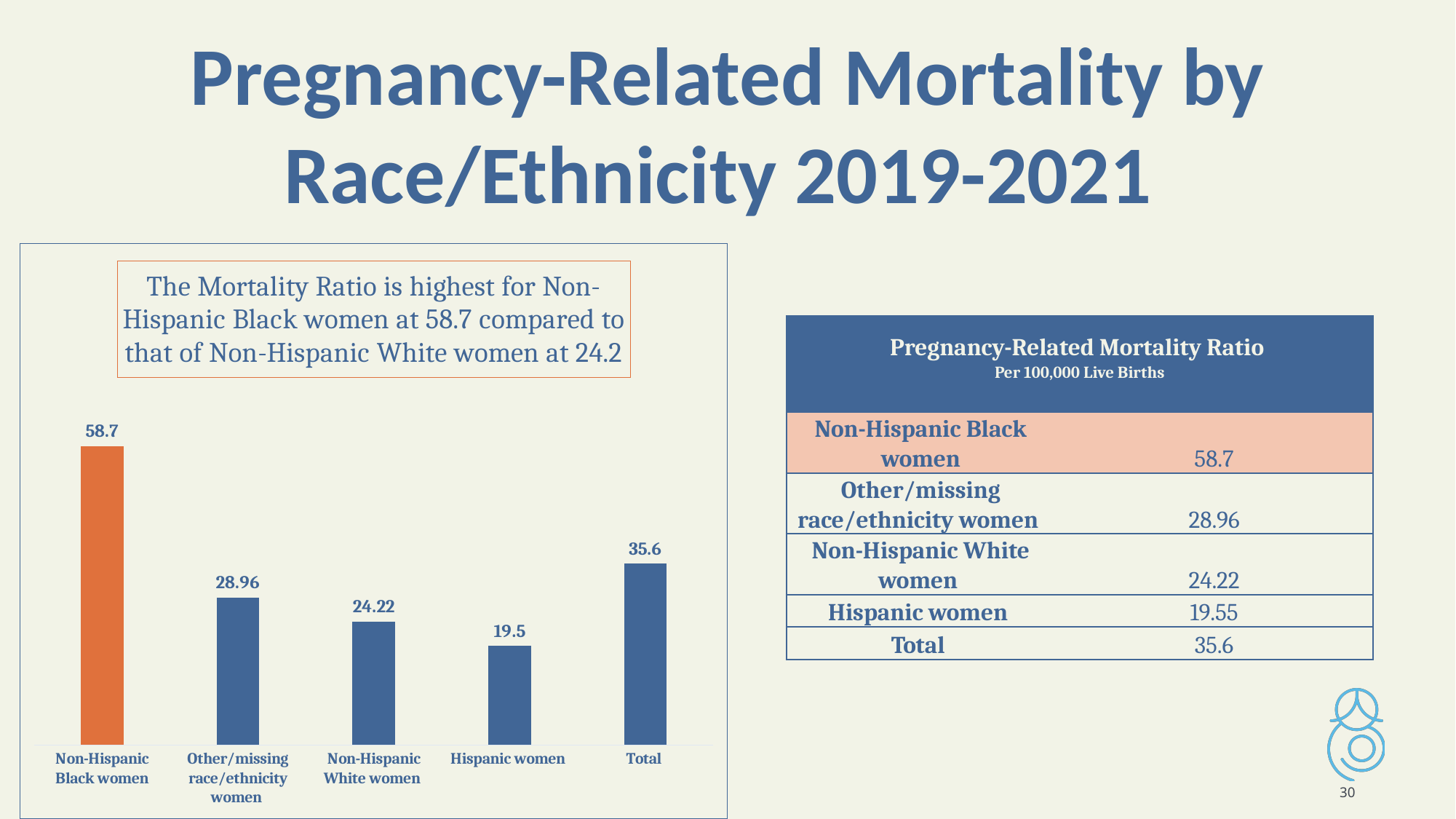
What is the value shown for Total in the bar chart? 35.6 What is the value shown for Non-Hispanic White women in the bar chart? 24.22 Which bar in the chart is coloured orange rather than blue? Non-Hispanic Black women Which is larger in the bar chart, the value for Other/missing race/ethnicity women or the value for Total? Total What is the value shown for Non-Hispanic Black women in the bar chart? 58.7 Which category has the lowest bar in the chart? Hispanic women Which category has the highest bar in the chart? Non-Hispanic Black women What is the difference between the values for Non-Hispanic Black women and Non-Hispanic White women in the bar chart? 34.48 What kind of chart is shown on the slide? Bar chart How many categories are shown in the bar chart? 5 What is the value shown for Other/missing race/ethnicity women in the bar chart? 28.96 What is the value shown for Hispanic women in the bar chart? 19.5